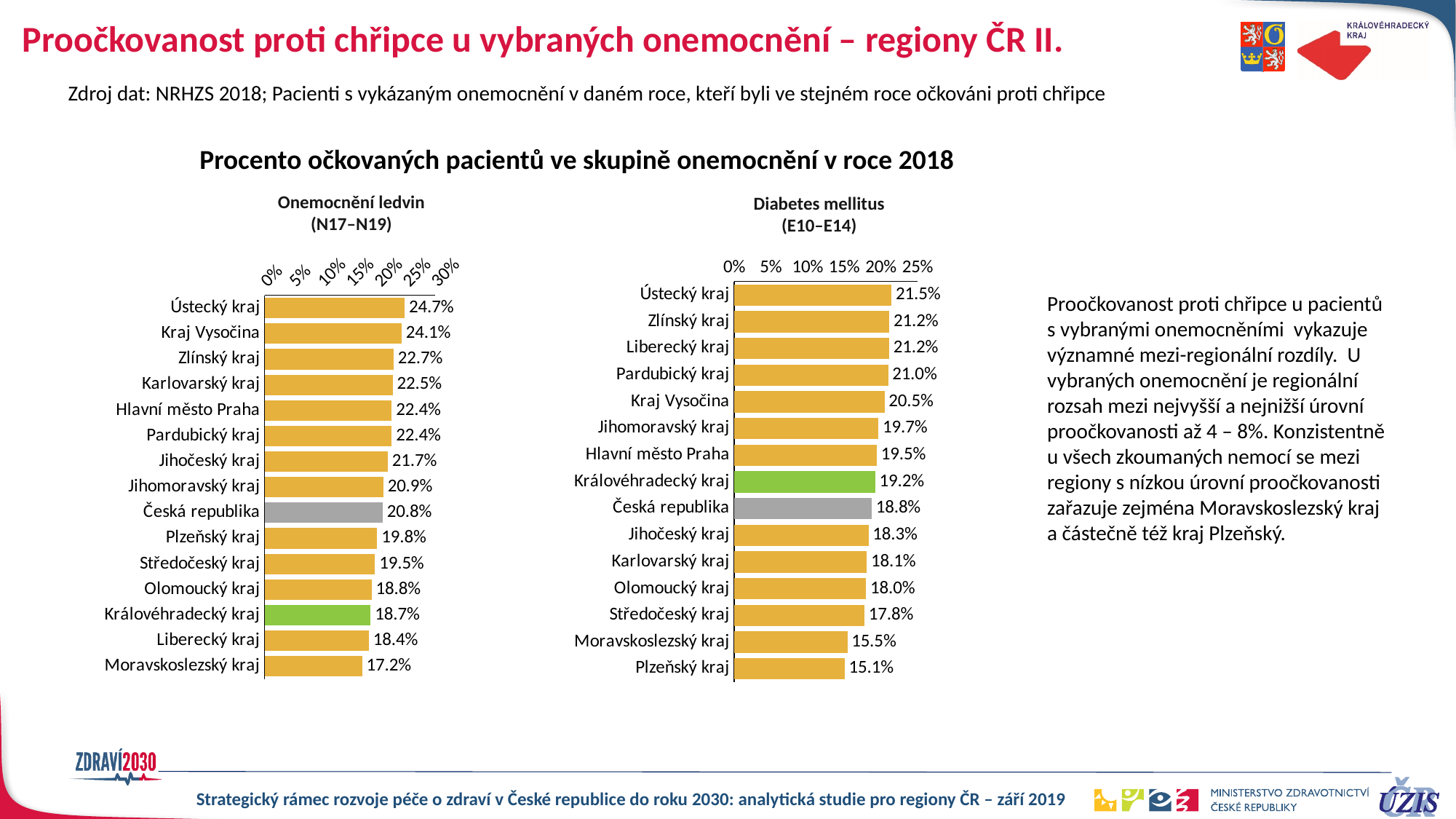
In the 'Onemocnění ledvin (N17–N19)' chart, which region has the lowest value? Moravskoslezský kraj In the 'Onemocnění ledvin (N17–N19)' chart, what is the value for Ústecký kraj? 24.7% How many bars are shown in the 'Onemocnění ledvin (N17–N19)' chart? 15 In the 'Onemocnění ledvin (N17–N19)' chart, which is larger: Kraj Vysočina or Zlínský kraj? Kraj Vysočina In the 'Diabetes mellitus (E10–E14)' chart, which region has the highest value? Ústecký kraj In the 'Diabetes mellitus (E10–E14)' chart, is the value for Moravskoslezský kraj greater or less than 20%? less What type of chart is the 'Diabetes mellitus (E10–E14)' chart? bar chart In the 'Diabetes mellitus (E10–E14)' chart, what is the value for Královéhradecký kraj? 19.2% In the 'Diabetes mellitus (E10–E14)' chart, what is the difference between Česká republika and Plzeňský kraj? 3.7% In the 'Onemocnění ledvin (N17–N19)' chart, what is the difference between Ústecký kraj and Moravskoslezský kraj? 7.5% In the 'Onemocnění ledvin (N17–N19)' chart, which bar is coloured green? Královéhradecký kraj In the 'Diabetes mellitus (E10–E14)' chart, which region has the lowest value? Plzeňský kraj